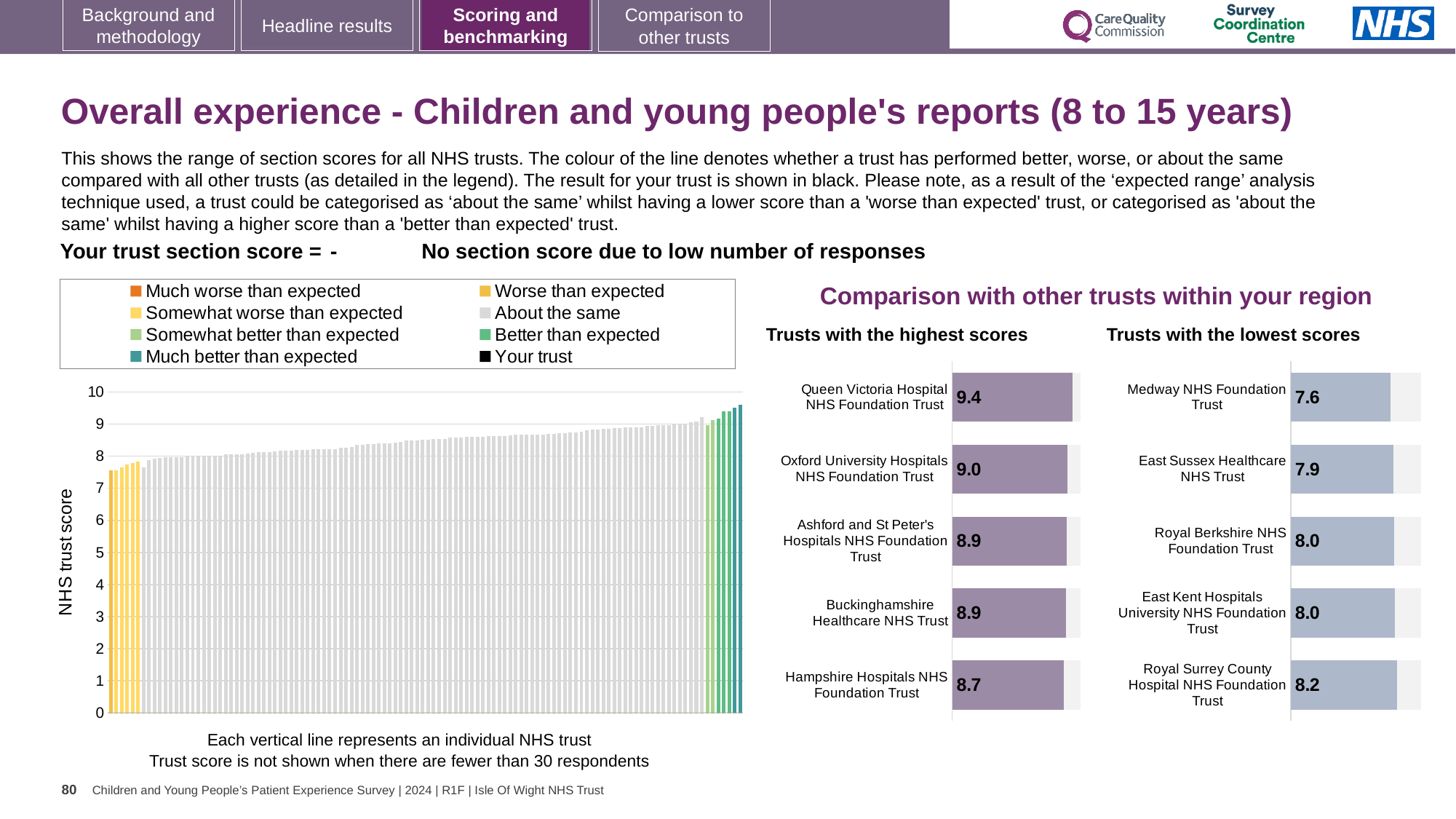
How many trusts are shown in the 'Trusts with the highest scores' chart? 5 In the 'Trusts with the highest scores' chart, which trust has the lowest score? Hampshire Hospitals NHS Foundation Trust In the large chart on the left, do the trust scores rise or fall from left to right? Rise In the 'Trusts with the lowest scores' chart, what is the difference between the scores of Royal Surrey County Hospital NHS Foundation Trust and Medway NHS Foundation Trust? 0.6 What kind of chart is the large chart on the left showing all NHS trusts? Bar chart In the 'Trusts with the highest scores' chart, what is the score for Buckinghamshire Healthcare NHS Trust? 8.9 How many entries does the legend of the large chart on the left list? 8 In the 'Trusts with the lowest scores' chart, which trust has the highest score? Royal Surrey County Hospital NHS Foundation Trust In the 'Trusts with the highest scores' chart, what is the difference between the scores of Queen Victoria Hospital NHS Foundation Trust and Oxford University Hospitals NHS Foundation Trust? 0.4 In the 'Trusts with the lowest scores' chart, which has the higher score: East Sussex Healthcare NHS Trust or Royal Berkshire NHS Foundation Trust? Royal Berkshire NHS Foundation Trust In the 'Trusts with the highest scores' chart, what is the score for Queen Victoria Hospital NHS Foundation Trust? 9.4 In the 'Trusts with the lowest scores' chart, what is the score for Medway NHS Foundation Trust? 7.6